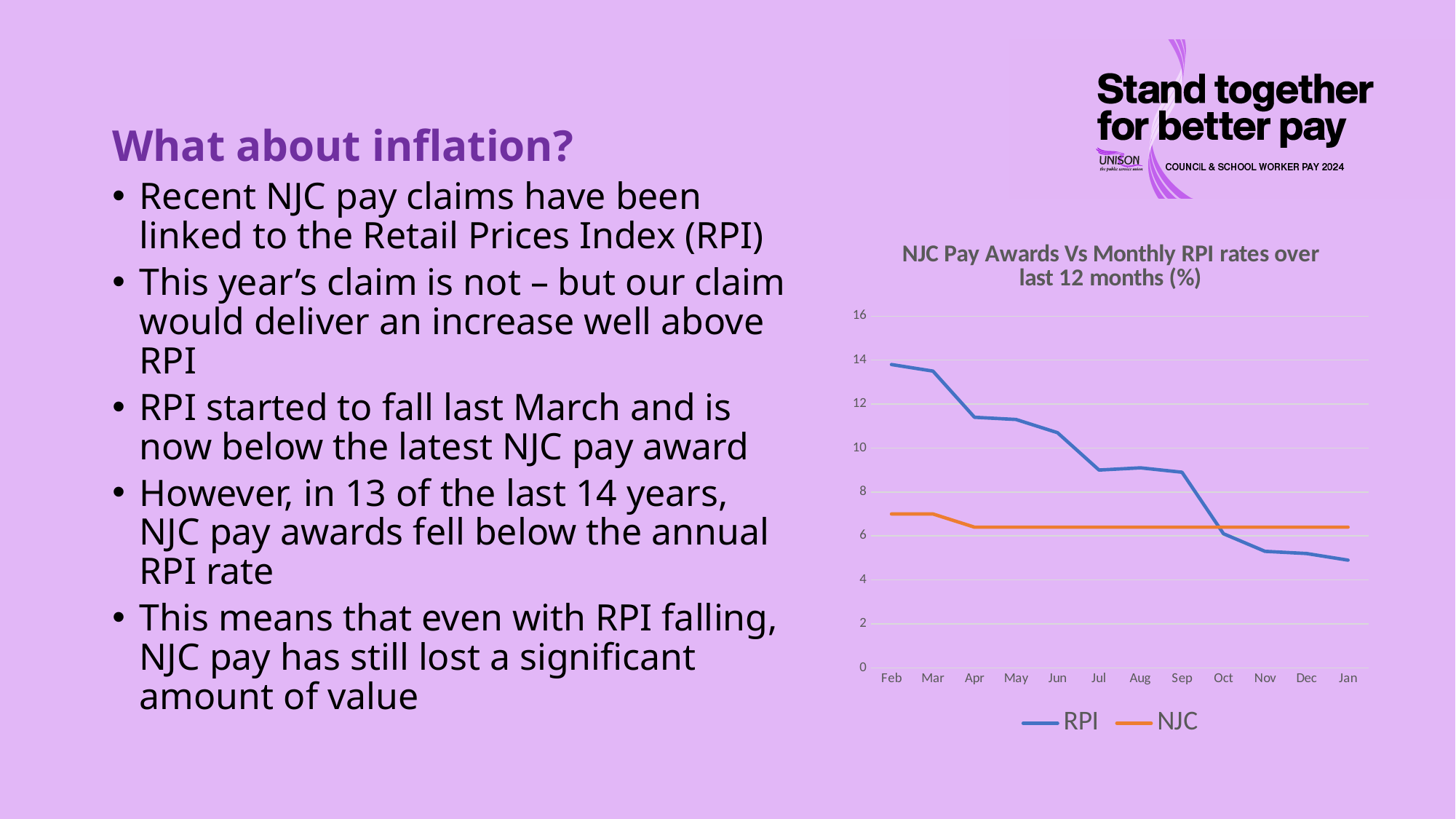
Is the NJC value for Jan greater or less than 8? less In Jan, which series has the larger value, RPI or NJC? NJC What kind of chart is shown on the slide? line chart In Feb, which series has the larger value, RPI or NJC? RPI Does the RPI line rise or fall from Feb to Jan? fall In which month is the RPI value highest? Feb How many months are shown along the x axis of the chart? 12 What is the title of the chart? NJC Pay Awards Vs Monthly RPI rates over last 12 months (%) Is the RPI value for Jul greater or less than 10? less Is the RPI value for Feb greater or less than 12? greater How many series does the chart's legend list? 2